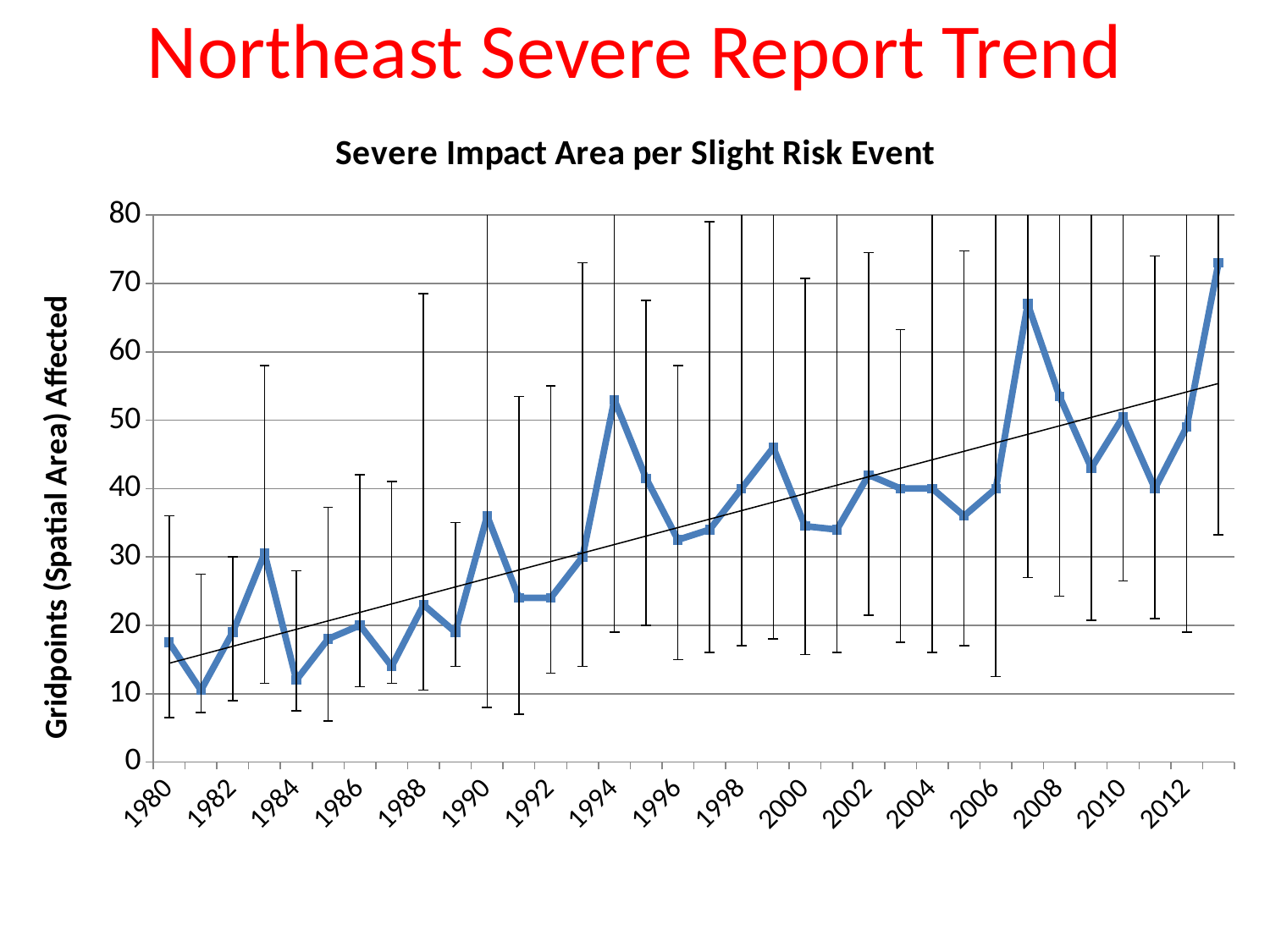
What kind of chart is shown on the slide? Line chart Is the value for 1994 greater or less than 50? greater What is the title of the chart? Severe Impact Area per Slight Risk Event Which year has the larger value, 1994 or 2007? 2007 Is the value for 1981 greater or less than 20? less Is the value for 1996 greater or less than 40? less What is the label on the vertical axis of the chart? Gridpoints (Spatial Area) Affected Which year has the larger value, 1983 or 1990? 1990 Overall, do the values rise or fall from 1980 to 2013? Rise Which year has the highest value on the chart? 2013